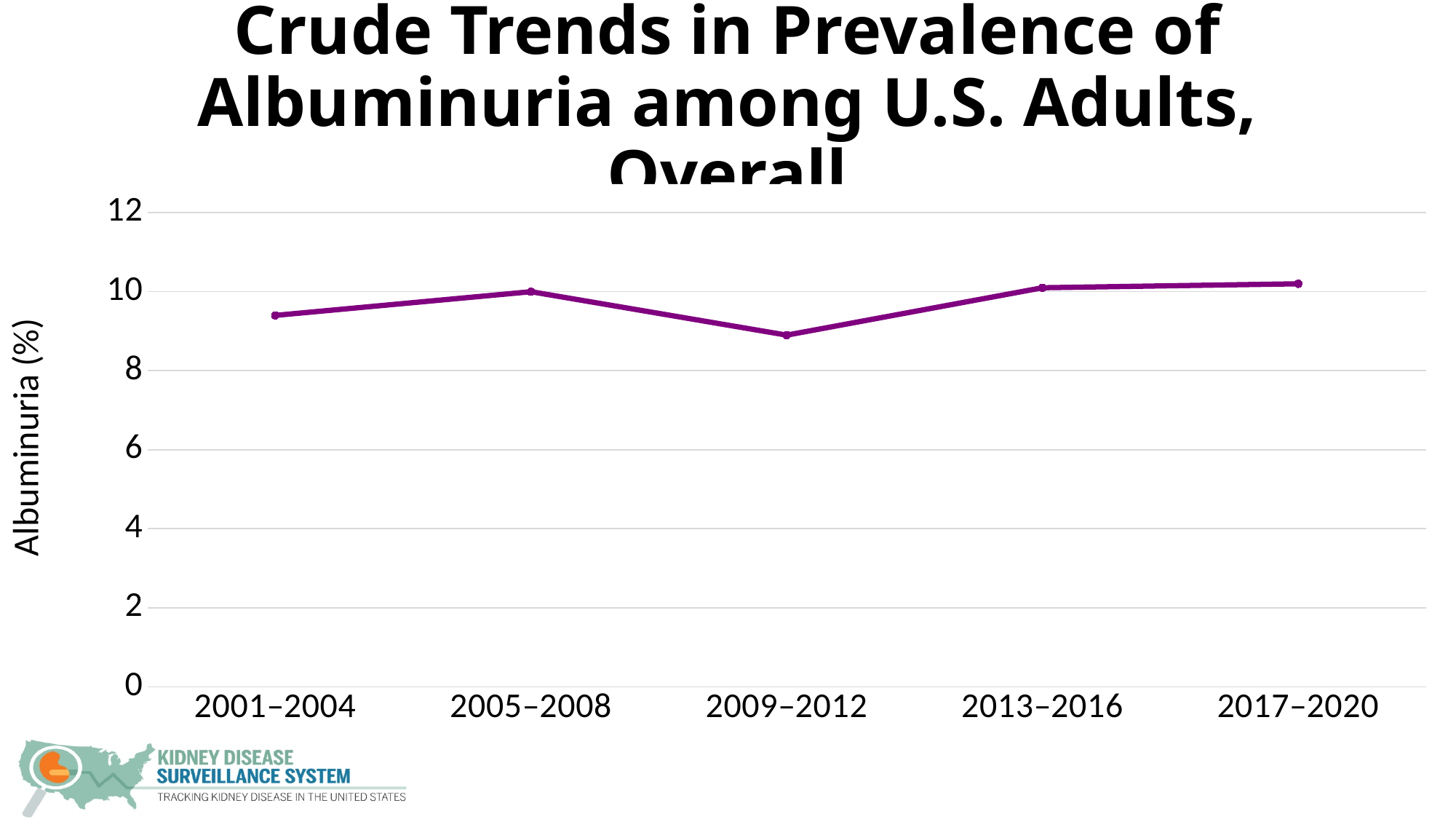
What kind of chart is shown on the slide? line chart Is the value for 2009–2012 greater or less than 10? less What is the label on the y axis? Albuminuria (%) Which is larger, the value for 2001–2004 or the value for 2009–2012? 2001–2004 Is the value for 2009–2012 greater or less than 8? greater Is the value for 2001–2004 greater or less than 10? less What colour is the plotted line? purple Which is larger, the value for 2005–2008 or the value for 2009–2012? 2005–2008 Which time period has the lowest albuminuria prevalence? 2009–2012 Do the values rise or fall from 2009–2012 to 2017–2020? rise How many time periods are plotted along the x axis? 5